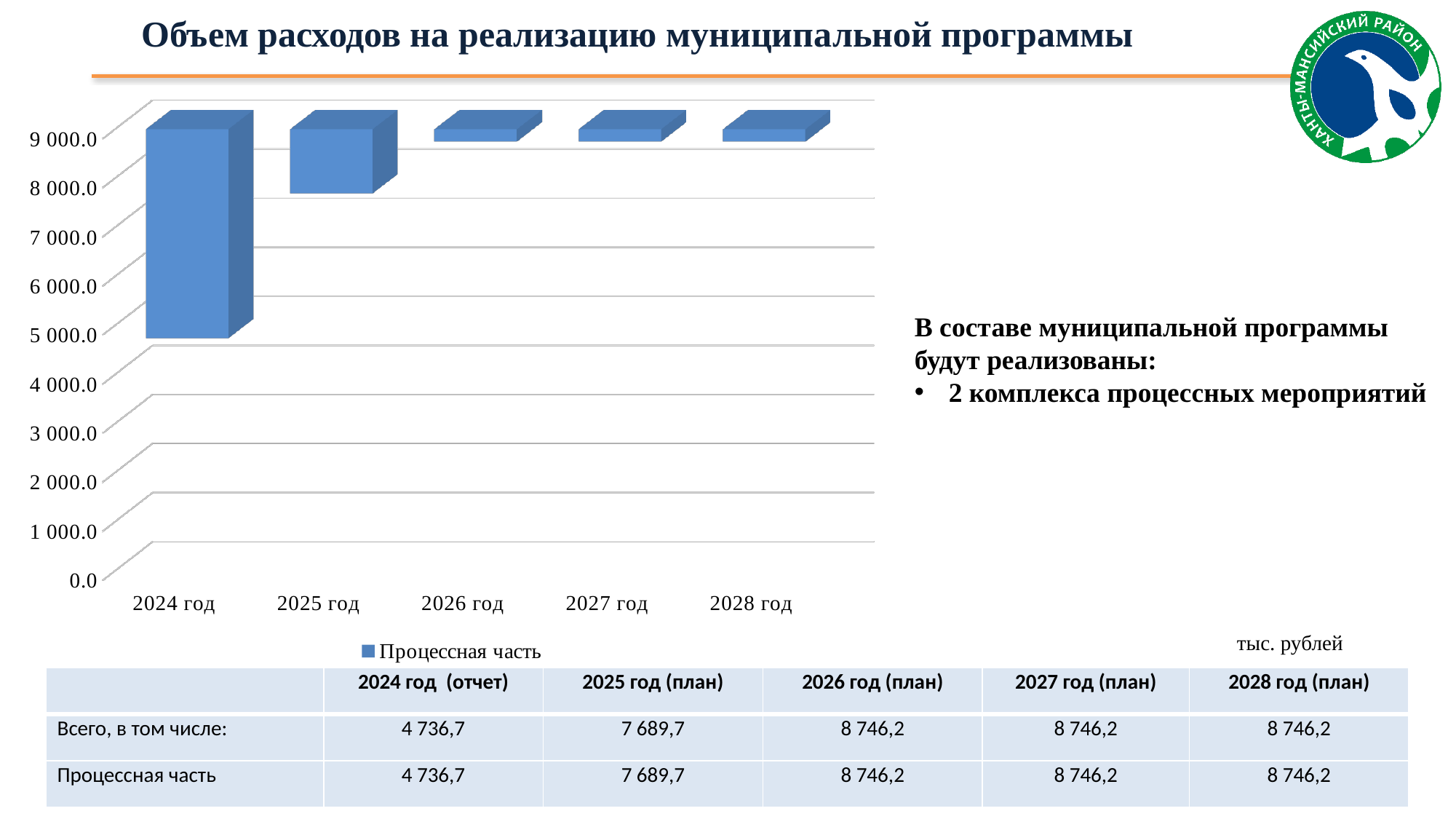
What is the name of the series shown in the chart legend? Процессная часть What is the title of the slide's chart? Объем расходов на реализацию муниципальной программы Which is larger, the value for 2025 год or the value for 2026 год? 2026 год Do the values rise or fall from 2024 год to 2026 год? rise How many series does the chart legend list? 1 What kind of chart is shown on the slide? bar chart What is the difference between the values for 2025 год and 2024 год? 2 953,0 What is the value of Процессная часть for 2025 год? 7 689,7 What is the value of Процессная часть for 2024 год? 4 736,7 How many categories (years) are shown on the x axis of the chart? 5 What is the value of Процессная часть for 2027 год? 8 746,2 Which year has the lowest value of Процессная часть? 2024 год